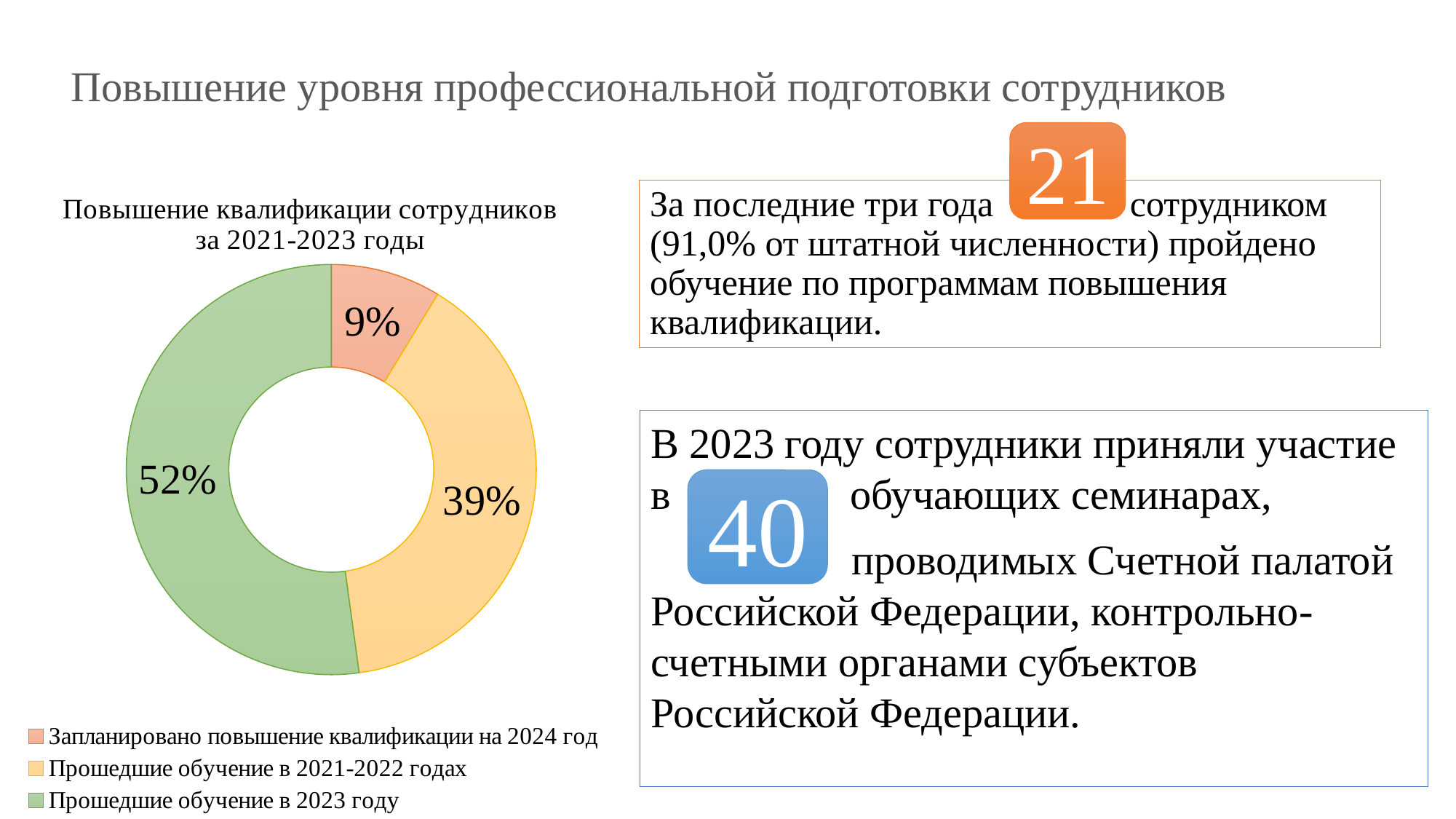
What is the combined share of the two categories of employees who completed training (2021-2022 and 2023)? 91% Which category has the largest share of the chart? Прошедшие обучение в 2023 году What colour is the slice for "Прошедшие обучение в 2023 году"? Green Which is larger: the share for "Прошедшие обучение в 2021-2022 годах" or the share for "Запланировано повышение квалификации на 2024 год"? Прошедшие обучение в 2021-2022 годах What type of chart is shown on the slide? Doughnut (pie) chart What is the difference in percentage points between "Прошедшие обучение в 2023 году" and "Прошедшие обучение в 2021-2022 годах"? 13 percentage points What share of the chart is labelled "Запланировано повышение квалификации на 2024 год"? 9% What is the title of the chart? Повышение квалификации сотрудников за 2021-2023 годы How many categories does the chart show? 3 Which category has the smallest share of the chart? Запланировано повышение квалификации на 2024 год What share of the chart is labelled "Прошедшие обучение в 2021-2022 годах"? 39% What share of the chart is labelled "Прошедшие обучение в 2023 году"? 52%